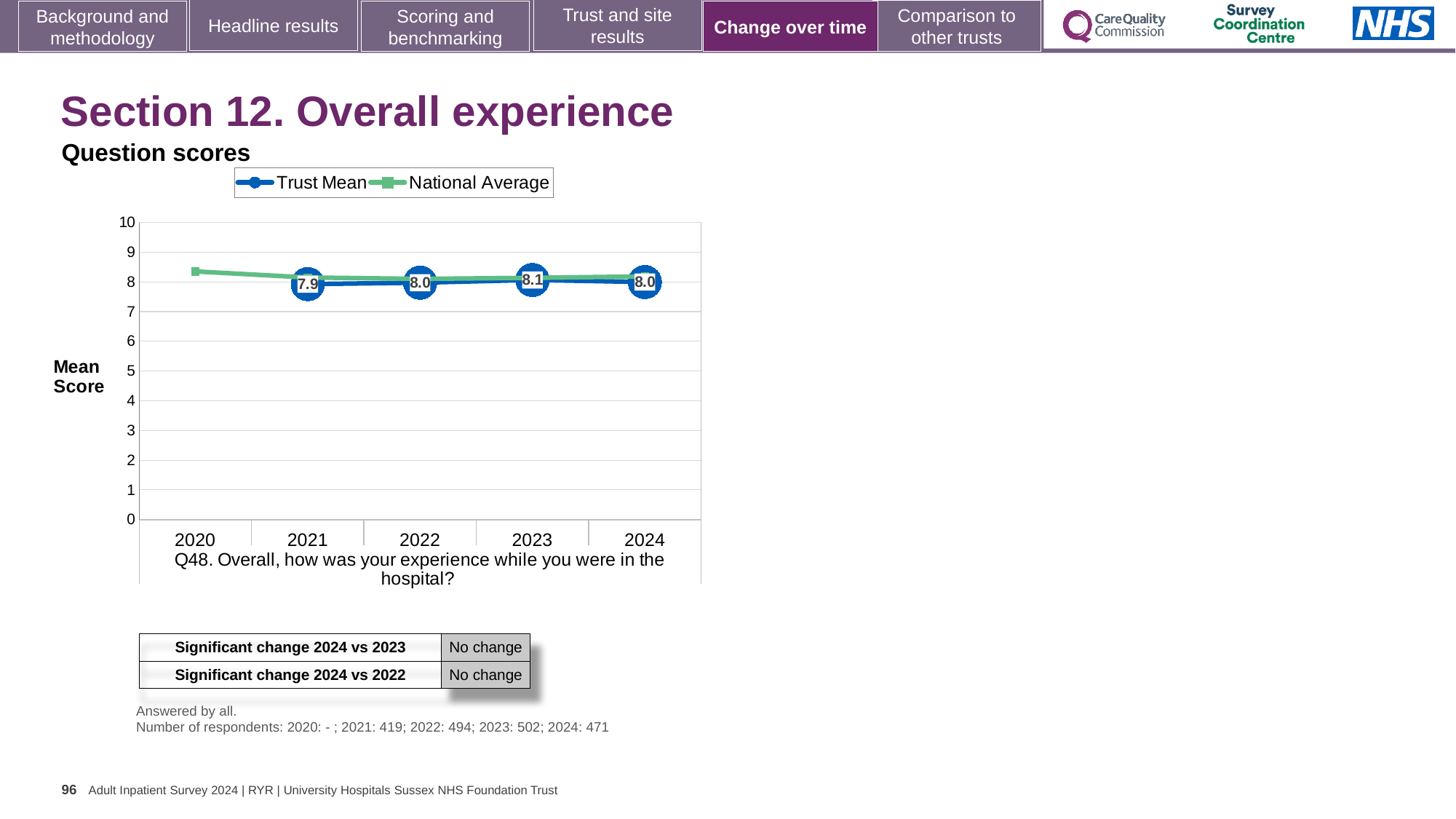
In which year is the Trust Mean score highest? 2023 How many years are shown on the x axis? 5 What is the difference between the Trust Mean scores for 2023 and 2021? 0.2 What is the Trust Mean score for 2024? 8.0 In which year is the Trust Mean score lowest? 2021 How many series does the legend list? 2 What is the Trust Mean score for 2023? 8.1 Is the National Average value for 2020 greater or less than 8? greater What is the label on the y axis? Mean Score What is the Trust Mean score for 2021? 7.9 Which is larger, the Trust Mean score for 2022 or for 2023? 2023 What kind of chart is shown? Line chart